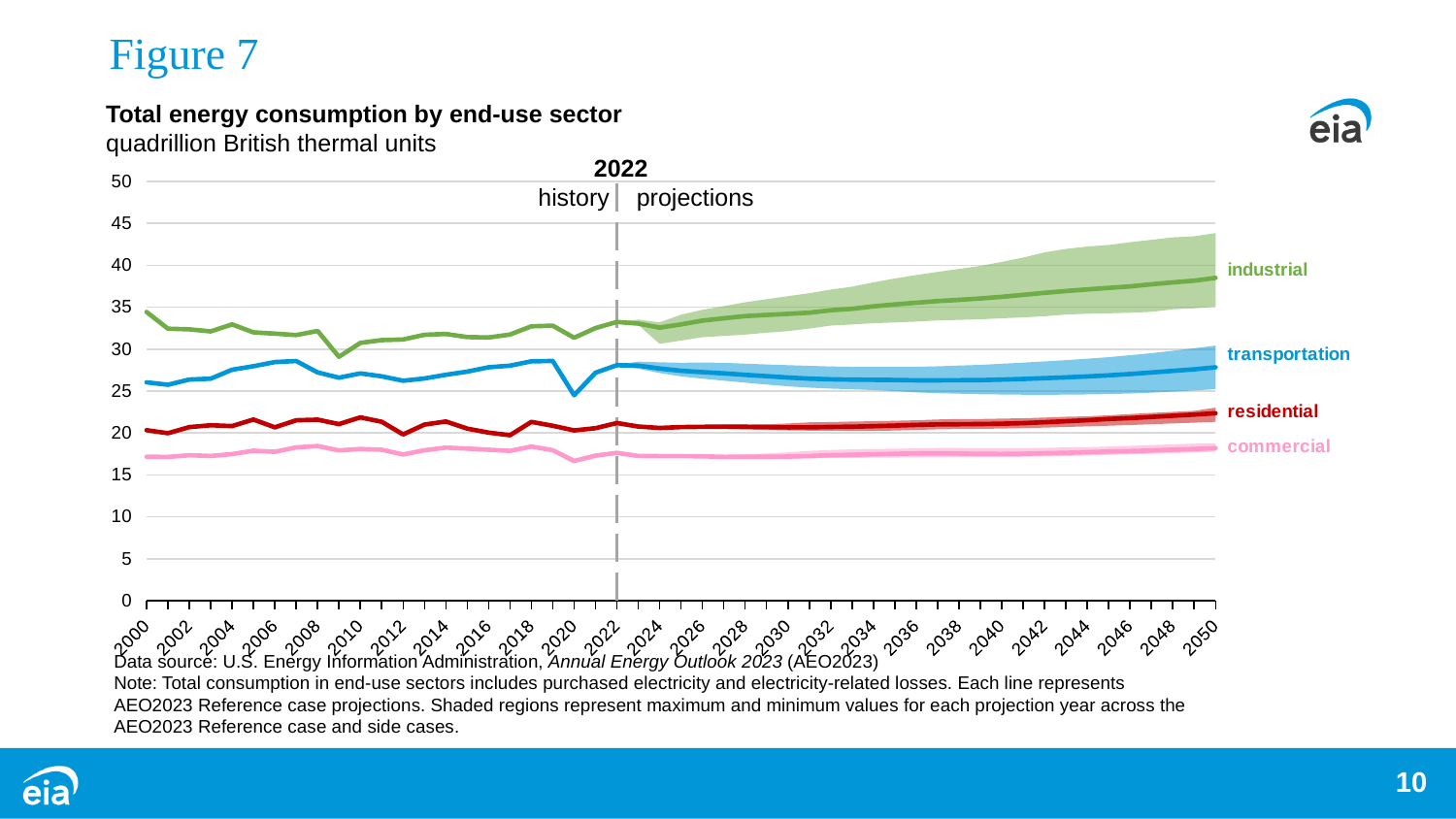
Is the industrial value in 2000 greater or less than 30? greater How many end-use sector series are plotted on the chart? 4 Is the commercial value in 2050 greater or less than 20? less Which end-use sector has the lowest energy consumption across the chart? commercial Is the industrial value in 2050 greater or less than 35? greater Which end-use sector has the highest energy consumption in 2050? industrial What unit of measurement is used on the chart? quadrillion British thermal units What kind of chart is shown on the slide? line chart Which year marks the boundary between history and projections on the chart? 2022 Does the industrial line rise or fall between 2022 and 2050? rise Which is larger in 2050, the industrial value or the transportation value? industrial